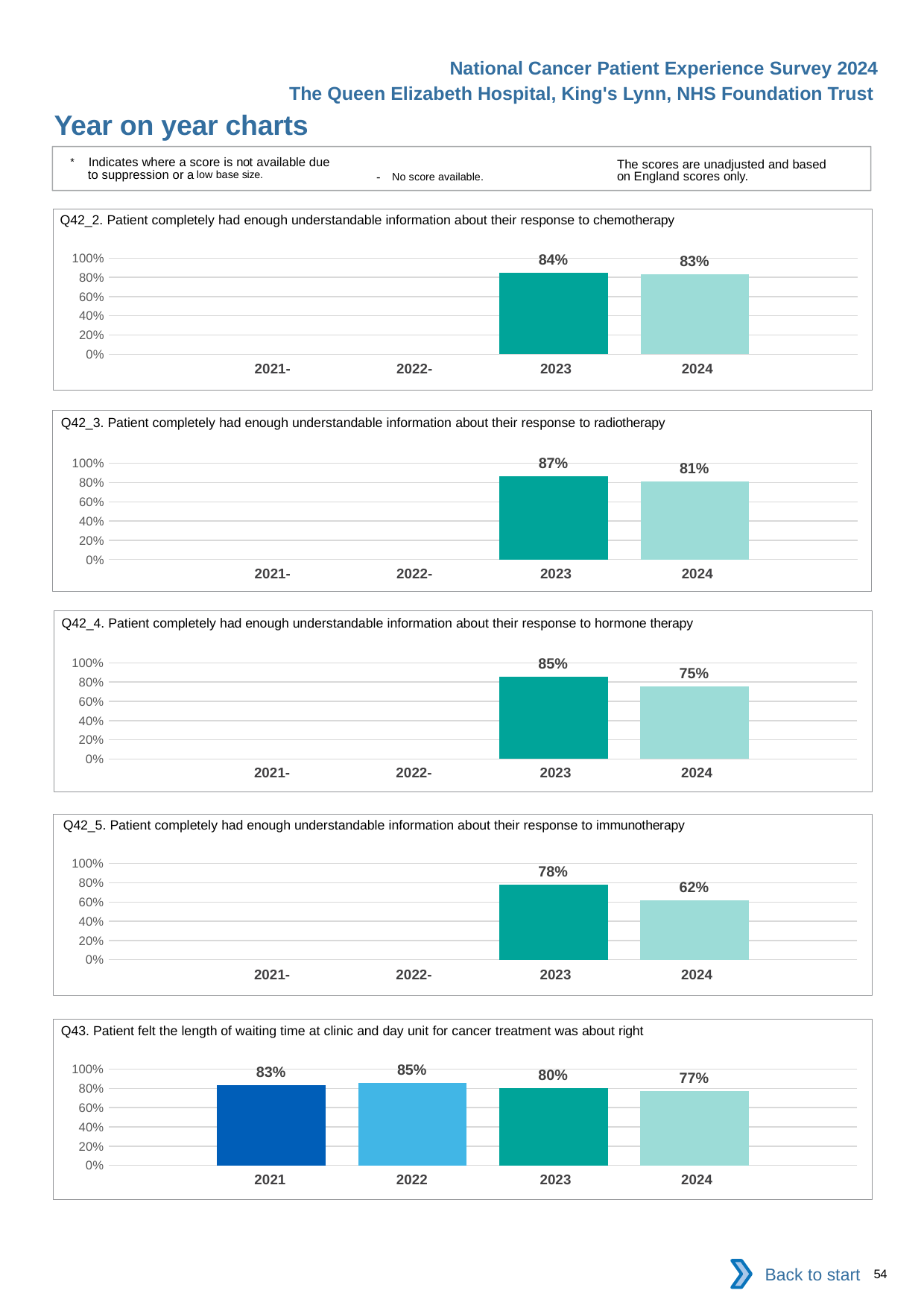
In the Q42_5 chart (immunotherapy), which year has the lower value, 2023 or 2024? 2024 In the Q42_2 chart (chemotherapy), what is the value for 2023? 84% In the Q42_2 chart (chemotherapy), what is the difference between the 2023 and 2024 values? 1 percentage point In the Q42_4 chart (hormone therapy), what is the difference between the 2023 and 2024 values? 10 percentage points In the Q42_3 chart (radiotherapy), what is the value for 2024? 81% In the Q43 chart (waiting time at clinic and day unit), which year has the highest value? 2022 What kind of chart is the Q42_3 chart (radiotherapy)? bar chart In the Q42_5 chart (immunotherapy), is the value for 2024 greater or less than 80%? less In the Q43 chart (waiting time at clinic and day unit), do the values rise or fall from 2022 to 2024? fall In the Q43 chart (waiting time at clinic and day unit), how many bars are plotted? 4 In the Q43 chart (waiting time at clinic and day unit), which year has the lowest value? 2024 In the Q43 chart (waiting time at clinic and day unit), what is the value for 2021? 83%